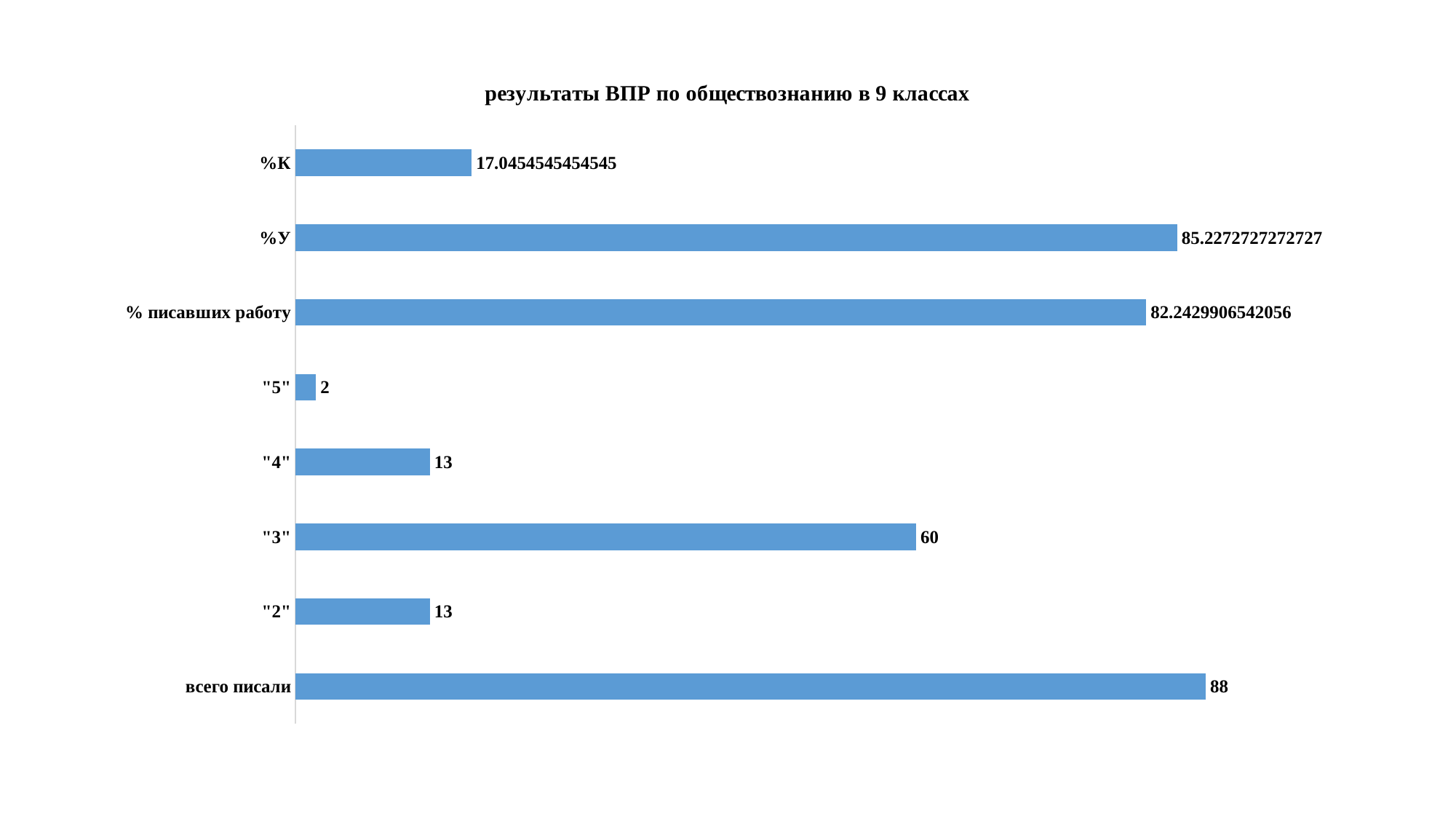
What is the value for "%К"? 17.0454545454545 What is the difference between the values for "3" and "4"? 47 What type of chart is shown? Bar chart What is the value for "5"? 2 Which category has the highest value? всего писали How many categories are shown in the chart? 8 Which category has the lowest value? "5" What is the value for "3"? 60 What is the value for "%У"? 85.2272727272727 What is the value for "всего писали"? 88 Which is larger, the value for "%У" or the value for "% писавших работу"? %У What is the value for "% писавших работу"? 82.2429906542056